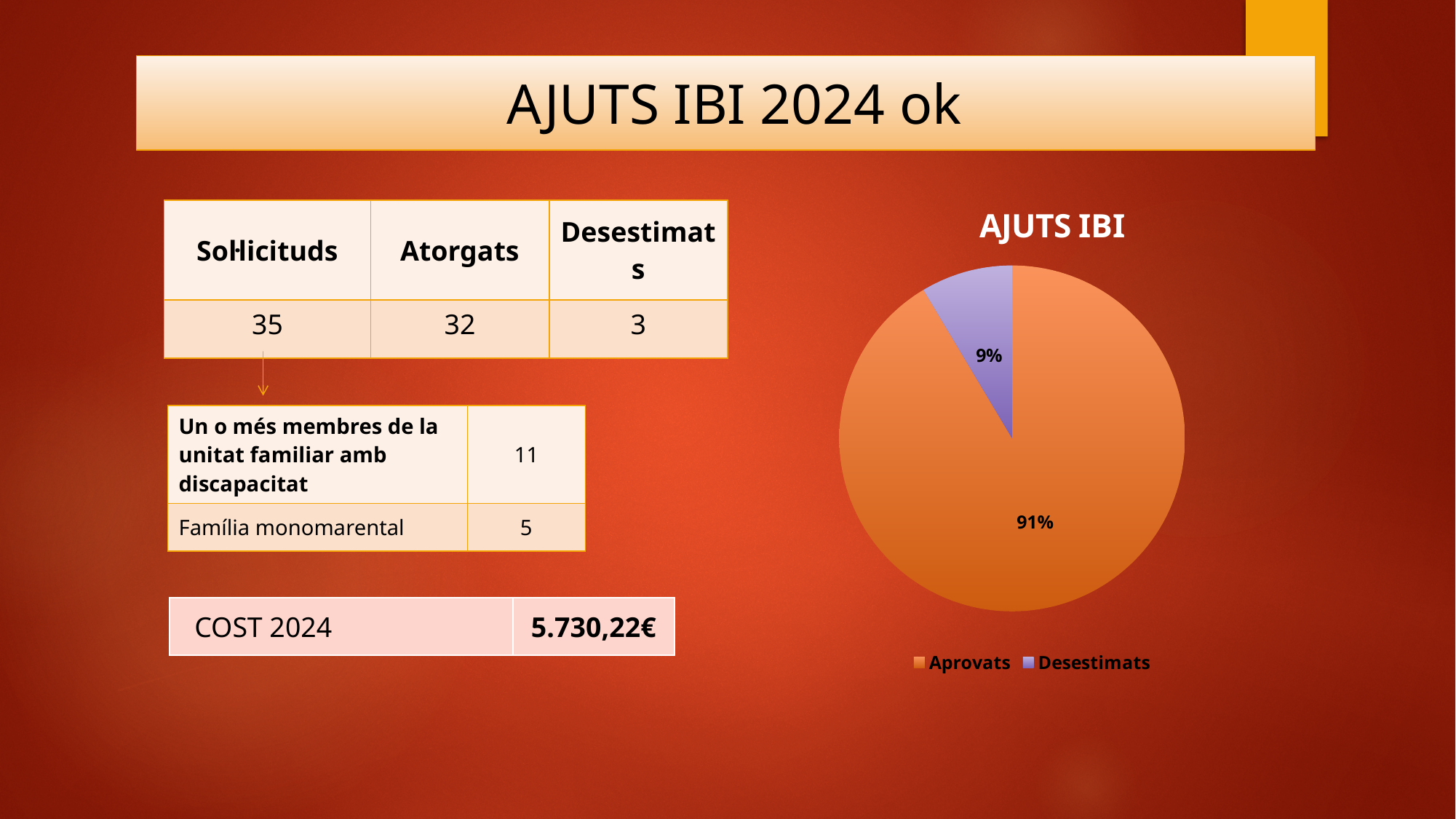
How many slices does the pie chart have? 2 What is the difference in percentage points between the Aprovats and Desestimats slices? 82 Which slice of the pie is the smallest? Desestimats What kind of chart is shown on the slide? pie chart Which slice of the pie is the largest? Aprovats Which is larger, the Aprovats slice or the Desestimats slice? Aprovats What share of the pie does Aprovats represent? 91% What colour is the Desestimats slice? purple What is the title of the chart? AJUTS IBI What share of the pie does Desestimats represent? 9% How many entries does the legend list? 2